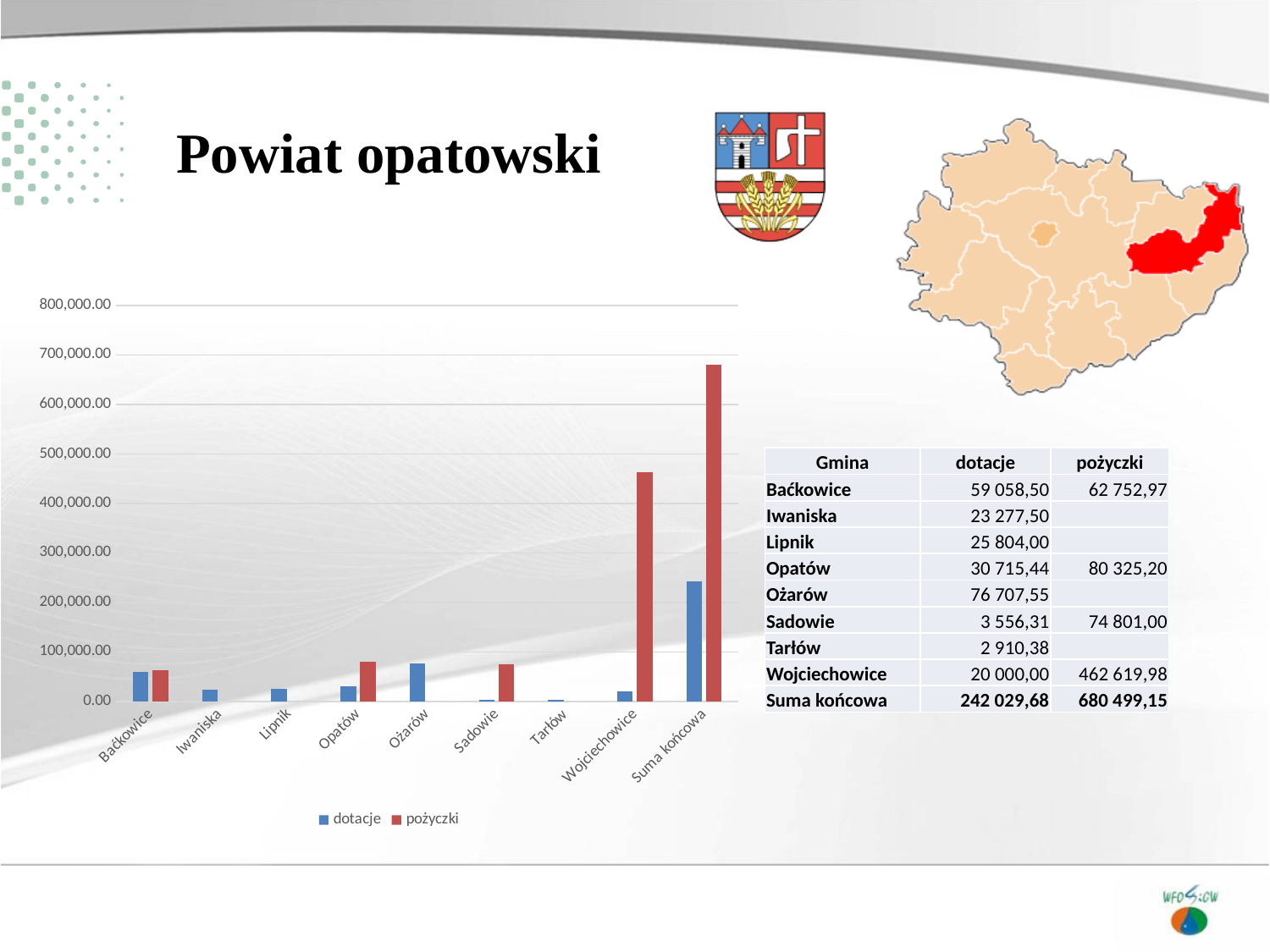
Excluding Suma końcowa, which gmina has the highest dotacje bar? Ożarów For Opatów, which is larger: dotacje or pożyczki? pożyczki Is the dotacje value for Ożarów greater or less than 100,000.00? less What kind of chart is shown on the slide? bar chart Which colour represents the pożyczki series in the chart? red Is the pożyczki value for Suma końcowa greater or less than 700,000.00? less How many categories are shown along the x axis of the chart? 9 What is the dotacje value for Suma końcowa, as printed in the table on the slide? 242 029,68 Which category has the tallest pożyczki bar in the chart? Suma końcowa How many series does the chart legend list? 2 What is the pożyczki value for Wojciechowice, as printed in the table on the slide? 462 619,98 Is the pożyczki value for Wojciechowice greater or less than 400,000.00? greater